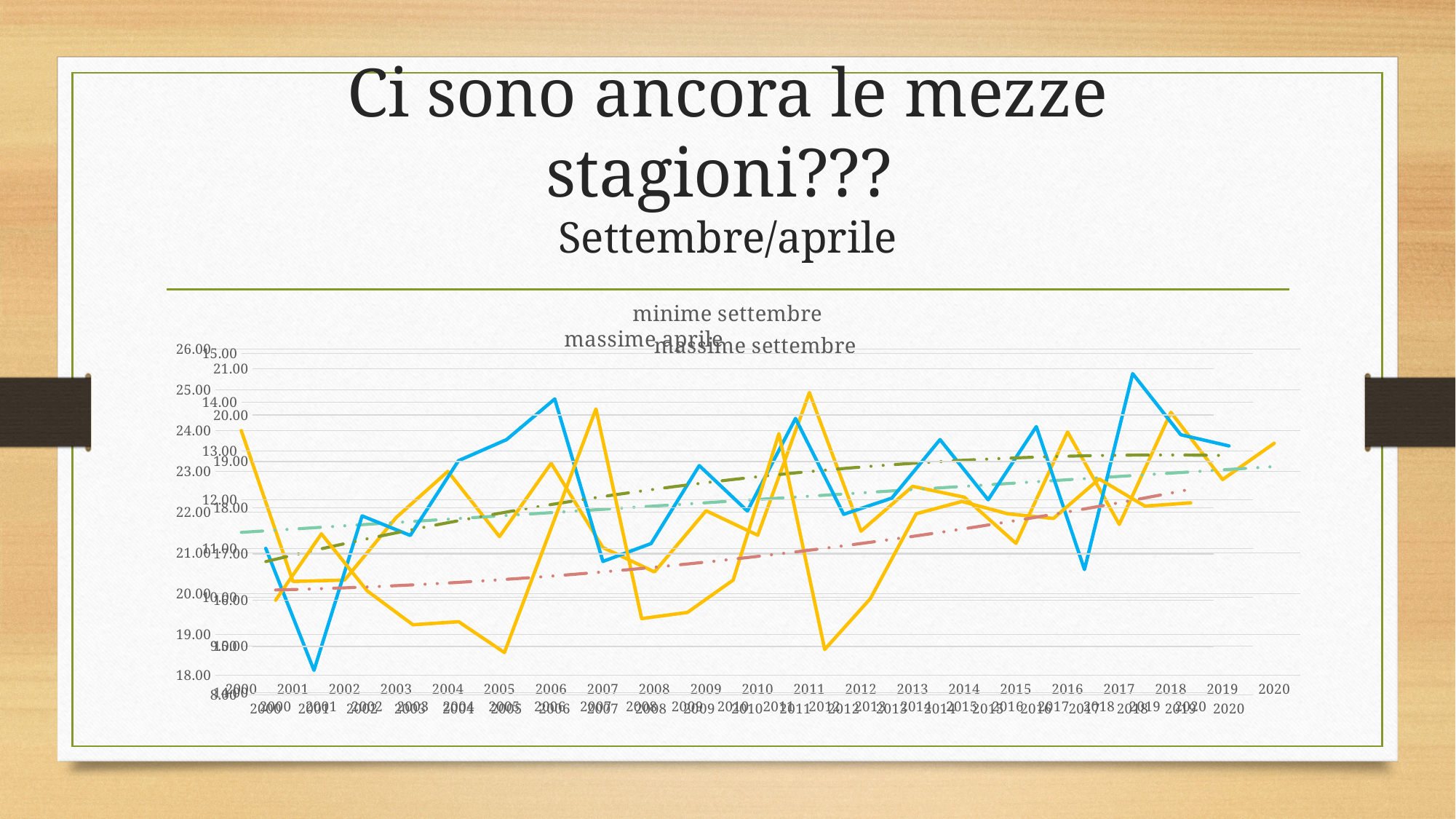
What kind of chart is used on this slide? line chart How many years are plotted along the x axis, from 2000 to 2020? 21 What is the last year shown on the x axis of the charts? 2020 How many chart titles are shown above the plot area? 3 Do the dotted trend lines rise or fall from 2000 to 2020? rise What is the first year shown on the x axis of the charts? 2000